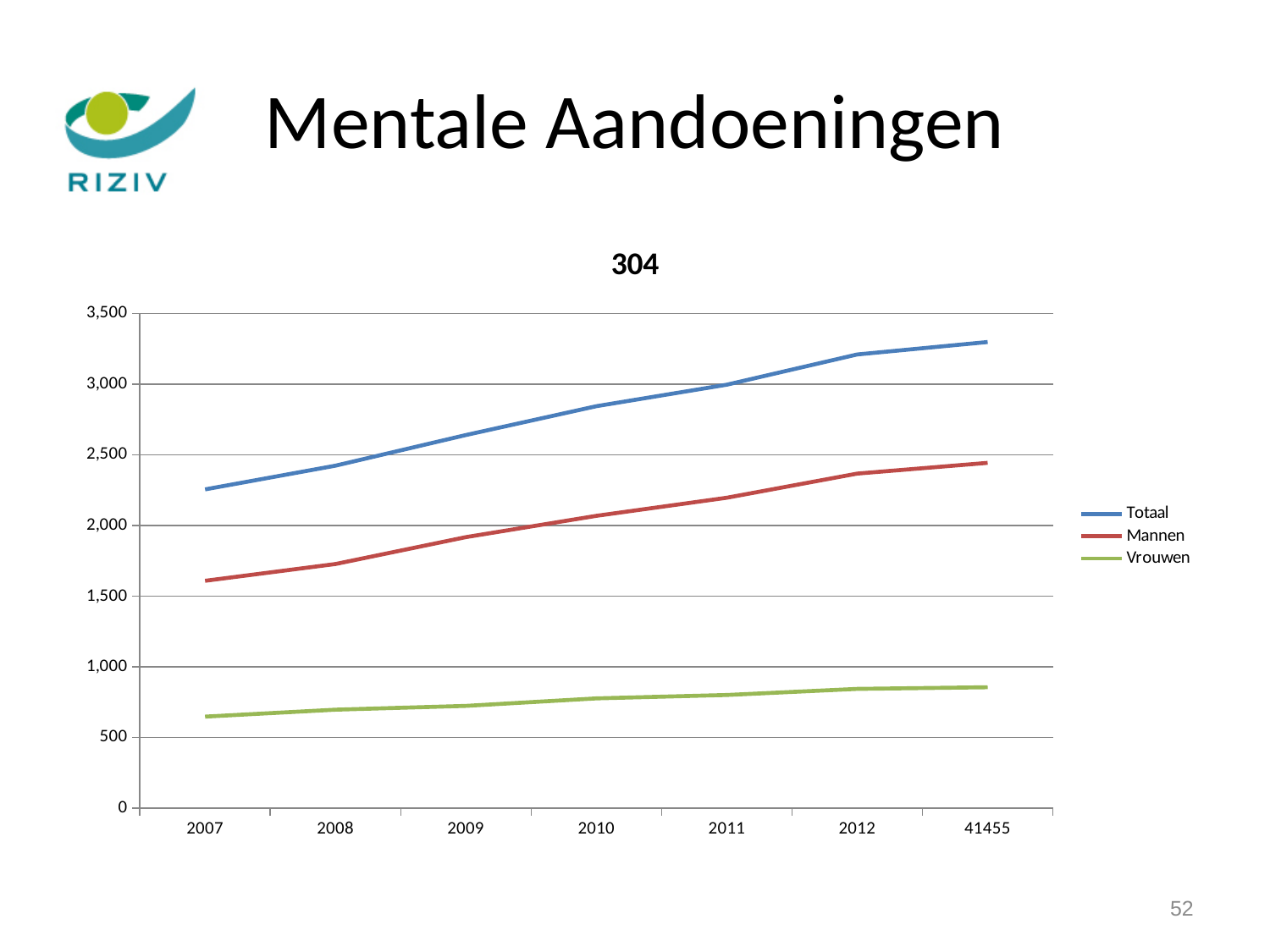
Is the value for Mannen in 2007 greater or less than 1,500? greater How many series does the legend list? 3 How many points are plotted along the x axis for each series? 7 What kind of chart is shown on the slide? line chart Which series has the highest values across all years? Totaal What is the title of the chart? 304 Does the Totaal series rise or fall from 2007 to 41455? rise Is the value for Totaal in 2007 greater or less than 2,000? greater Which series has the lowest values across all years? Vrouwen Is the value for Vrouwen in 41455 greater or less than 1,000? less Which is larger in 2012, the value for Mannen or the value for Vrouwen? Mannen Which series is shown in green in the legend? Vrouwen